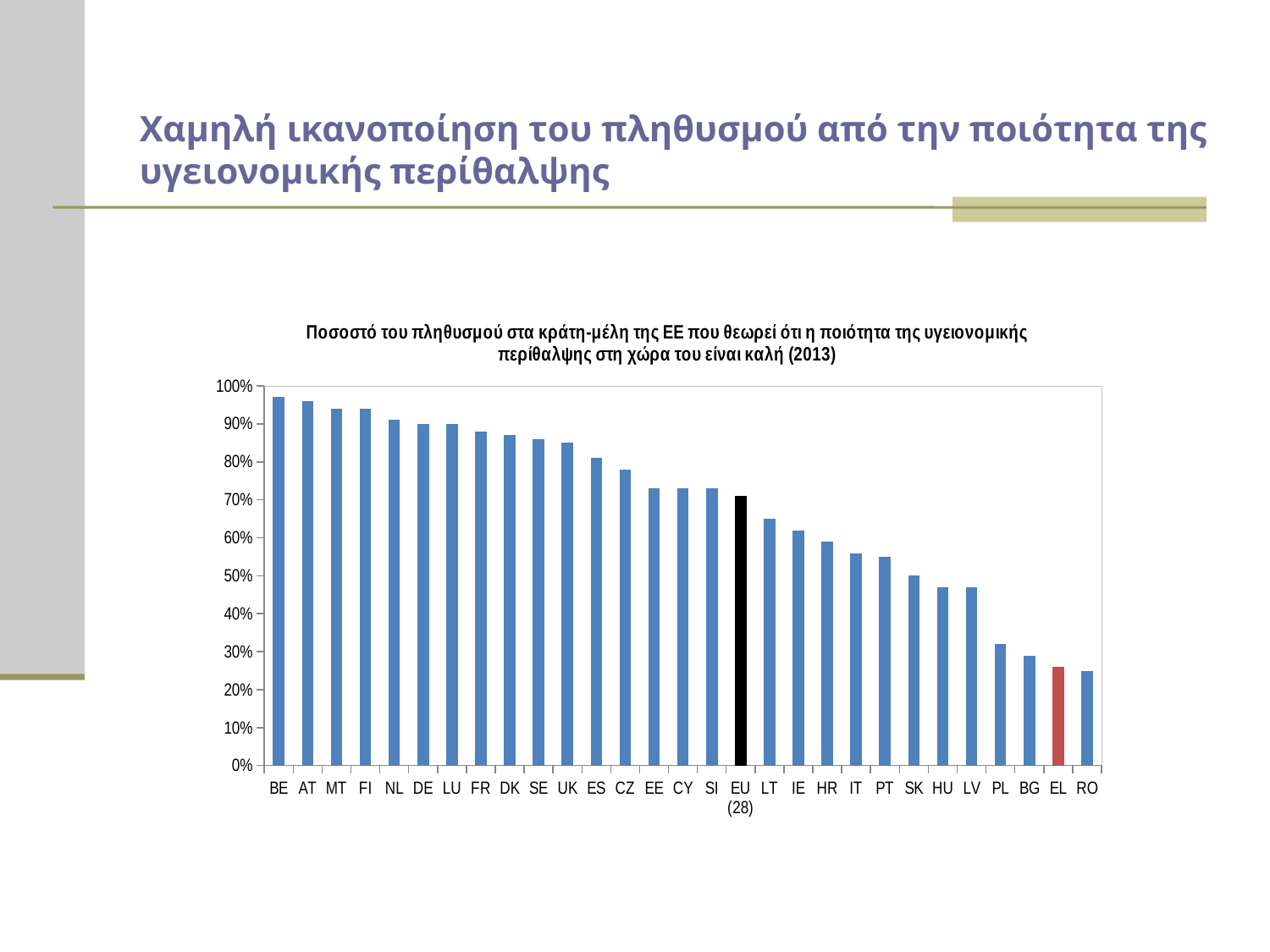
Which category's bar is coloured red? EL How many countries/categories are plotted along the x axis? 29 Do the values rise or fall moving from left to right along the x axis? fall What kind of chart is shown on the slide? bar chart Is the value for SK greater or less than 60%? less Is the value for PL greater or less than 40%? less Is the value for ES greater or less than 70%? greater Which category has the highest value? BE Which has a larger value, DE or IT? DE